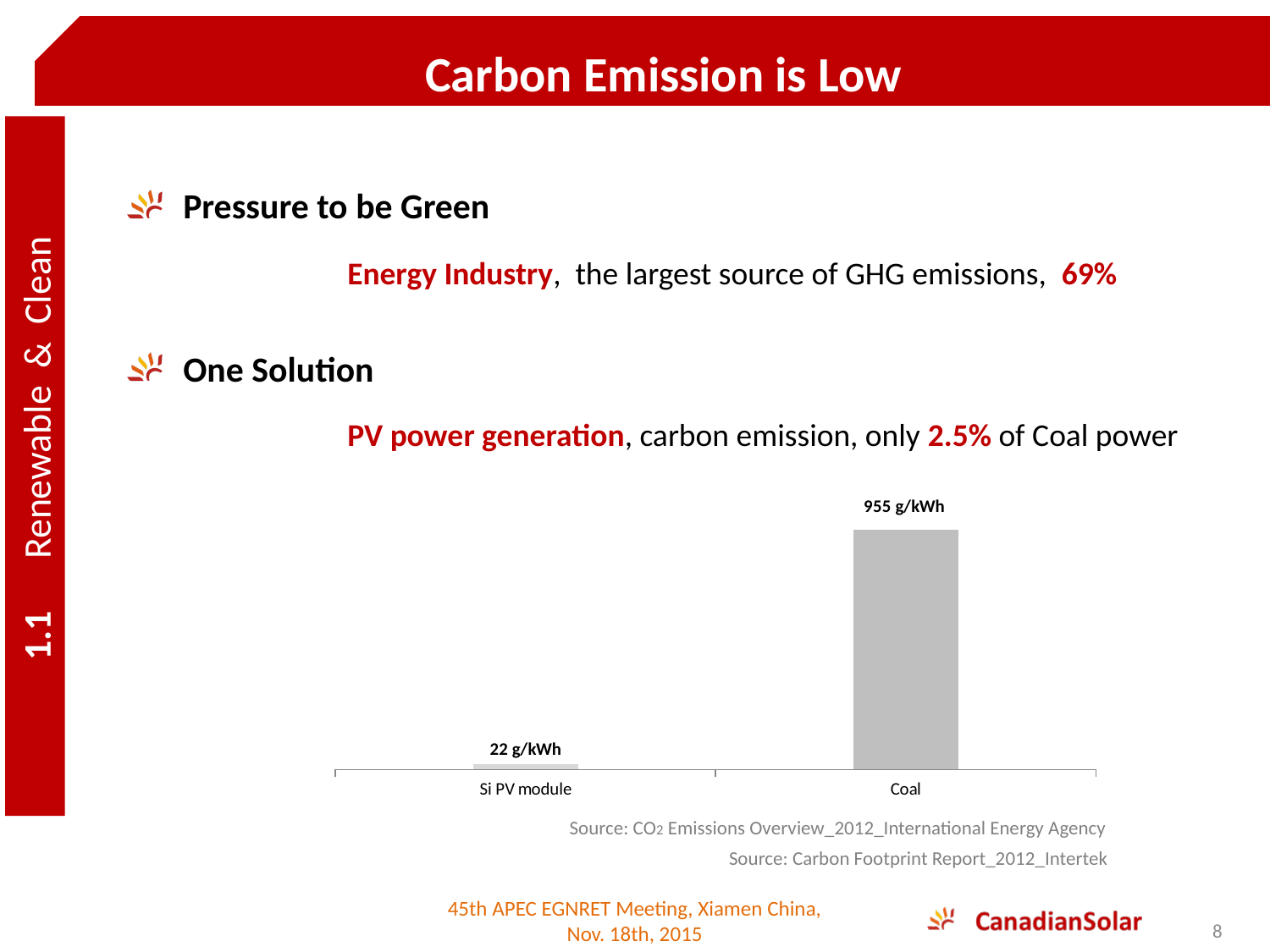
What kind of chart is shown on the slide? Bar chart How many categories are shown in the chart? 2 Do the values rise or fall from Si PV module to Coal along the x axis? Rise What colour are the bars in the chart? Grey What is the title of the slide containing the chart? Carbon Emission is Low Which category has the lowest value in the chart? Si PV module What is the carbon emission value shown for Si PV module? 22 g/kWh What is the difference between the Coal value and the Si PV module value? 933 g/kWh Which has a larger value, Si PV module or Coal? Coal What is the carbon emission value shown for Coal? 955 g/kWh Which category has the highest value in the chart? Coal